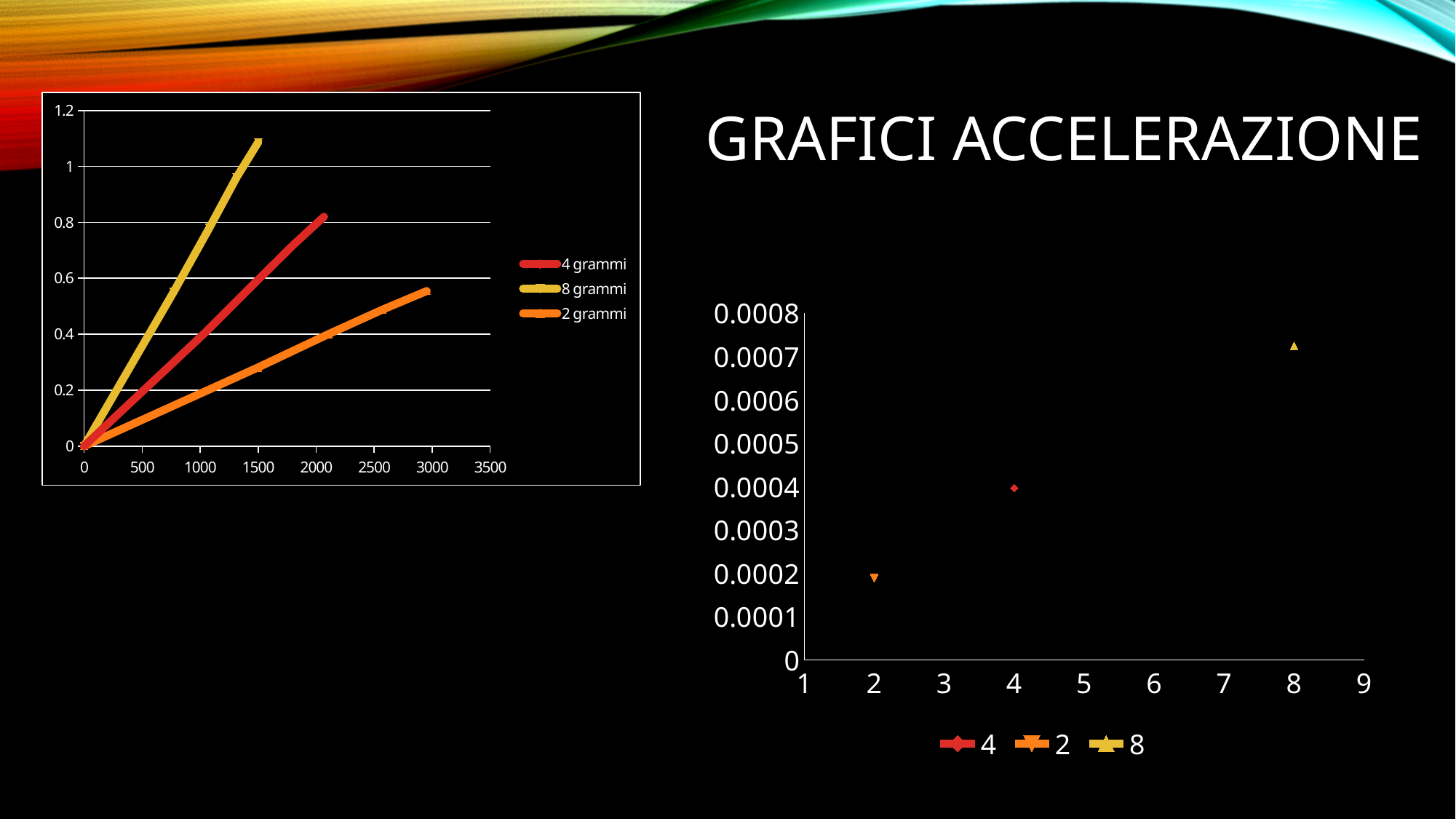
What kind of chart is the left chart? line chart On the right chart, which series has the highest plotted value? 8 On the right chart, which is larger, the value for series 4 or the value for series 2? 4 On the left chart, which series reaches the lowest maximum value? 2 grammi On the left chart, is the highest value of the 2 grammi series greater or less than 0.6? less What kind of chart is the right chart? scatter chart On the left chart, which series reaches the highest value? 8 grammi On the right chart, how many series does the legend list? 3 On the left chart, is the highest value of the 8 grammi series greater or less than 1? greater On the left chart, how many series does the legend list? 3 On the left chart, do the values of the 4 grammi series rise or fall as x increases? rise On the right chart, is the value for series 8 greater or less than 0.0006? greater